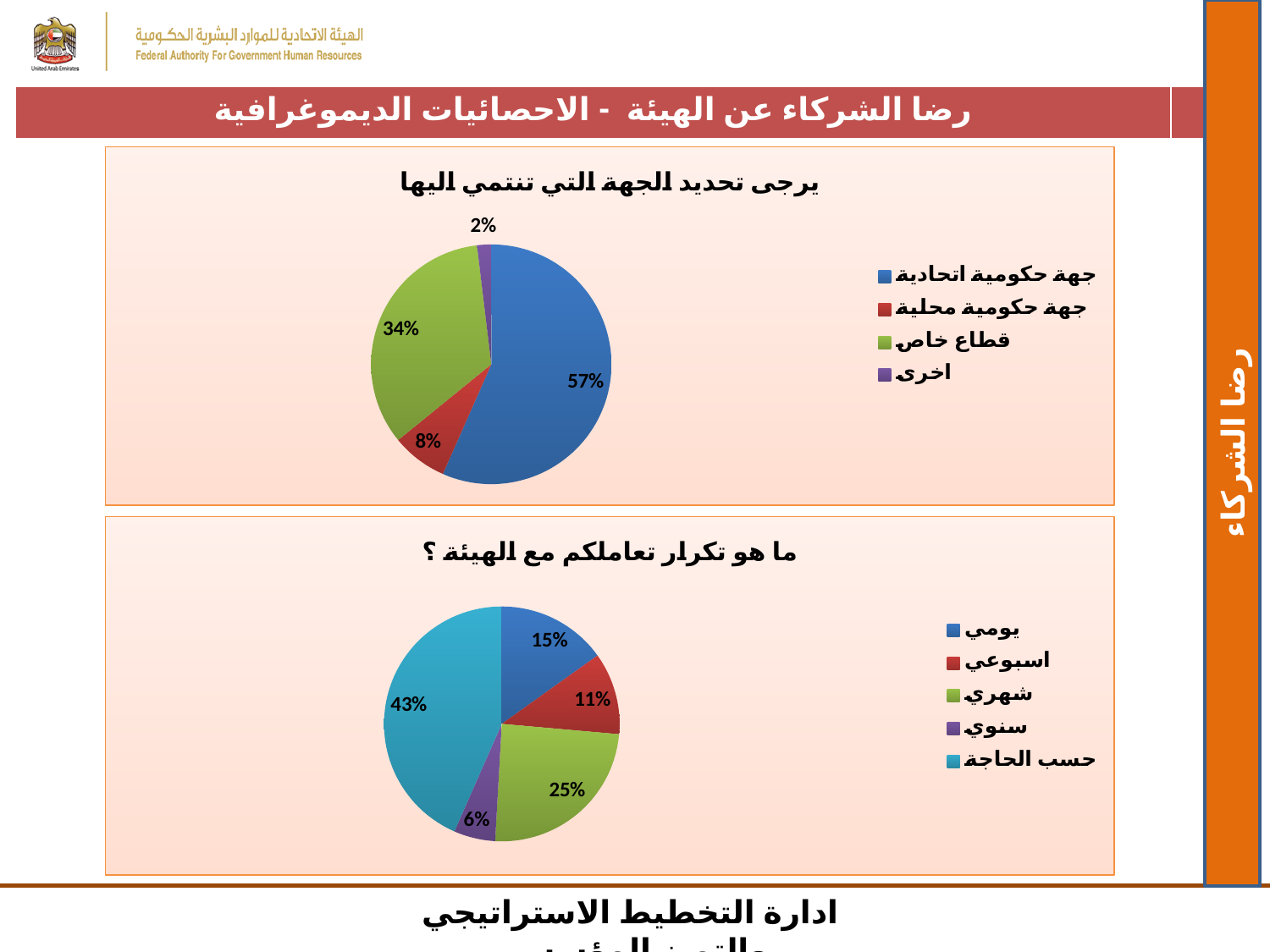
In the top chart, which category has the smallest slice? اخرى In the bottom chart, what percentage is shown for شهري? 25% How many slices does the bottom chart have? 5 In the bottom chart, what is the difference between the shares of شهري and سنوي? 19% In the top chart (يرجى تحديد الجهة التي تنتمي اليها), what share is labelled for جهة حكومية اتحادية? 57% In the top chart, what percentage is shown for قطاع خاص? 34% In the bottom chart, which category has the largest slice? حسب الحاجة In the bottom chart, which is larger: يومي or اسبوعي? يومي In the top chart, what is the difference between the shares of جهة حكومية اتحادية and قطاع خاص? 23% What type of chart is the bottom chart (ما هو تكرار تعاملكم مع الهيئة ؟)? pie chart In the bottom chart, what percentage is shown for حسب الحاجة? 43% How many categories does the legend of the top chart list? 4